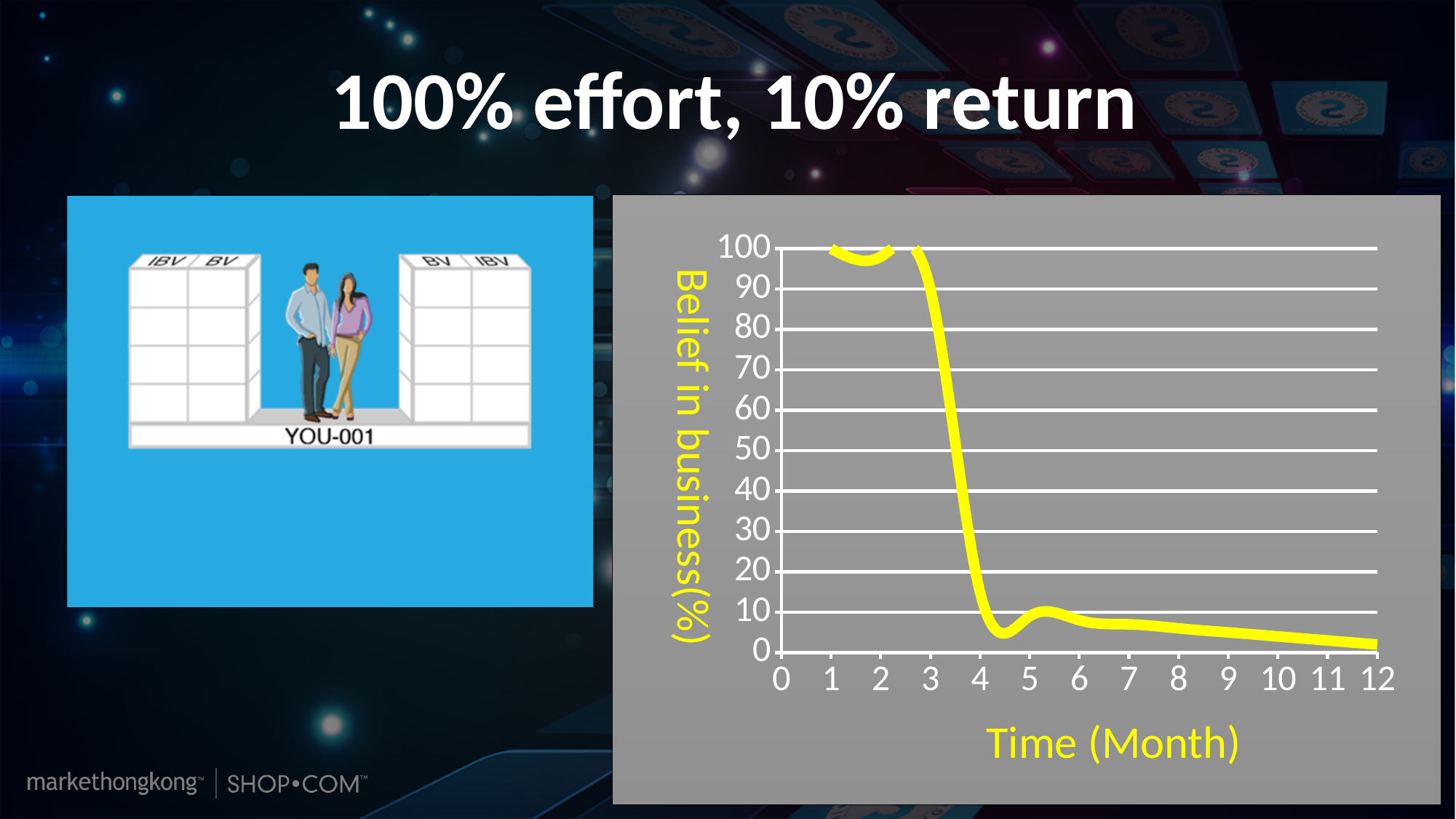
What is the label of the y axis of the chart? Belief in business(%) What kind of chart is shown on the slide? line chart What is the label of the x axis of the chart? Time (Month) Is the belief in business at month 3 greater or less than 50? greater Is the belief in business at month 12 greater or less than 10? less Is the belief in business at month 8 greater or less than 20? less Which month has a lower belief in business, month 1 or month 10? month 10 What is the highest value shown on the x axis of the chart? 12 Overall, does the belief in business rise or fall as time goes from month 1 to month 12? fall Which month has a higher belief in business, month 2 or month 6? month 2